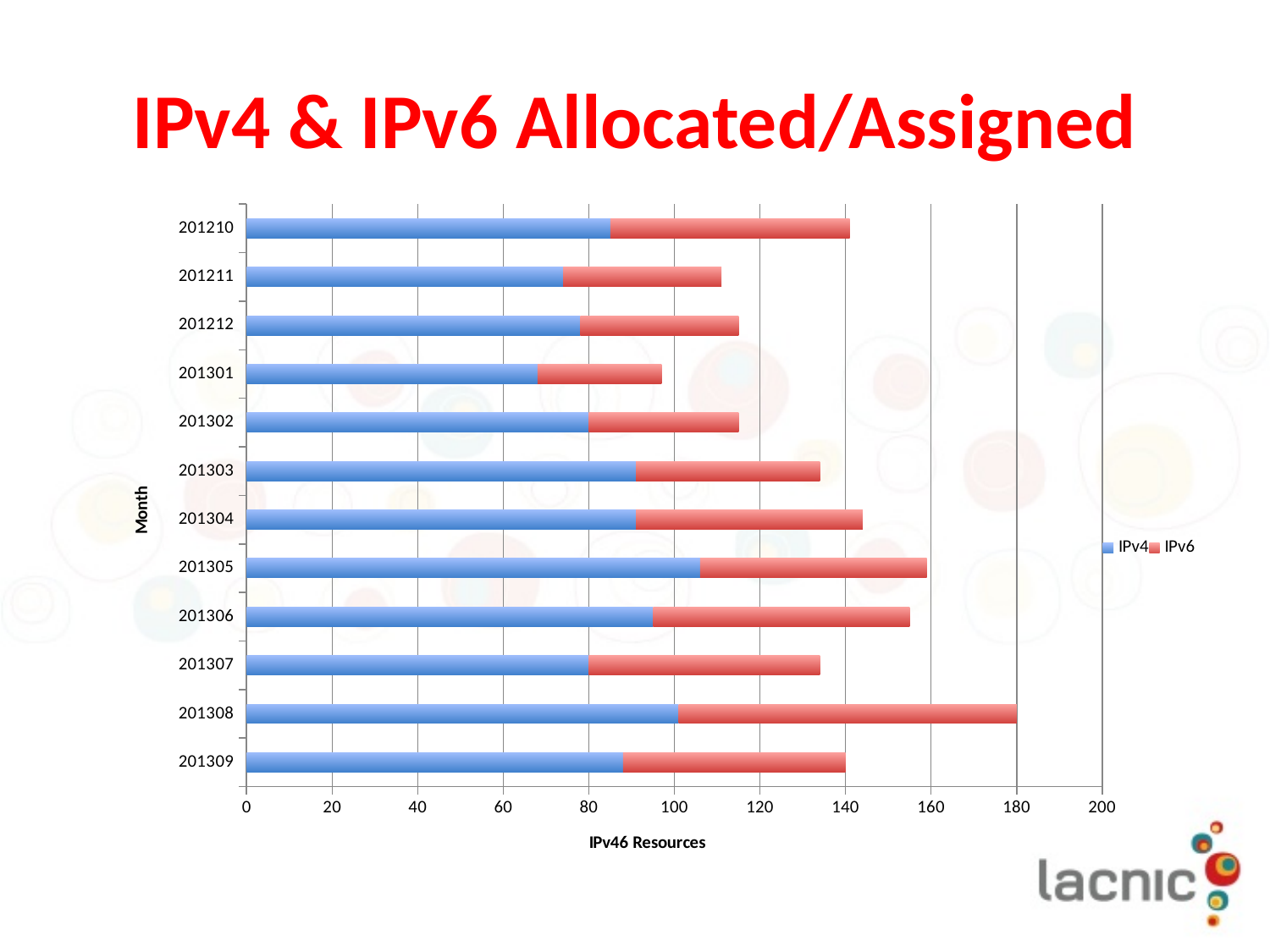
Is the IPv4 value for 201301 greater or less than 80? less What is the title of the horizontal axis? IPv46 Resources Which month has the highest total bar length? 201308 Is the total value for 201301 greater or less than 100? less What kind of chart is shown on the slide? bar chart How many months are plotted on the chart? 12 What are the two series named in the legend? IPv4 and IPv6 How many series does the legend list? 2 Which month has the lowest total bar length? 201301 Which has the larger total bar, 201305 or 201307? 201305 Is the total value for 201305 greater or less than 140? greater